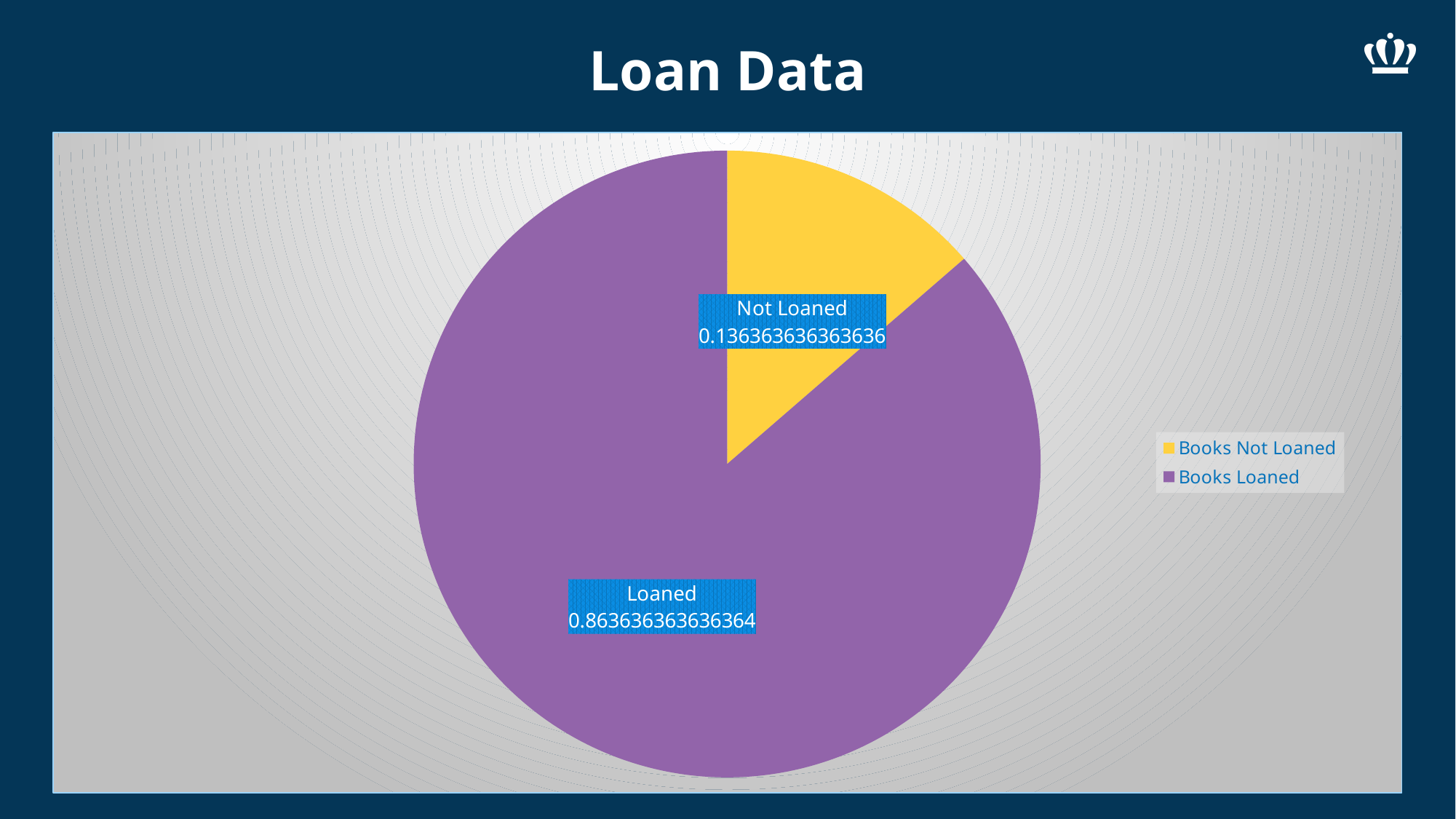
What value is shown for the Loaned slice? 0.863636363636364 What value is shown for the Not Loaned slice? 0.136363636363636 How many slices does the pie chart have? 2 What is the title of the chart? Loan Data What colour is the Books Loaned slice? purple What is the difference between the Loaned value and the Not Loaned value? 0.727272727272728 Which slice of the pie is the largest? Loaned How many entries does the legend list? 2 Which is larger, the Loaned slice or the Not Loaned slice? Loaned What type of chart is shown on the slide? pie chart Which slice of the pie is the smallest? Not Loaned